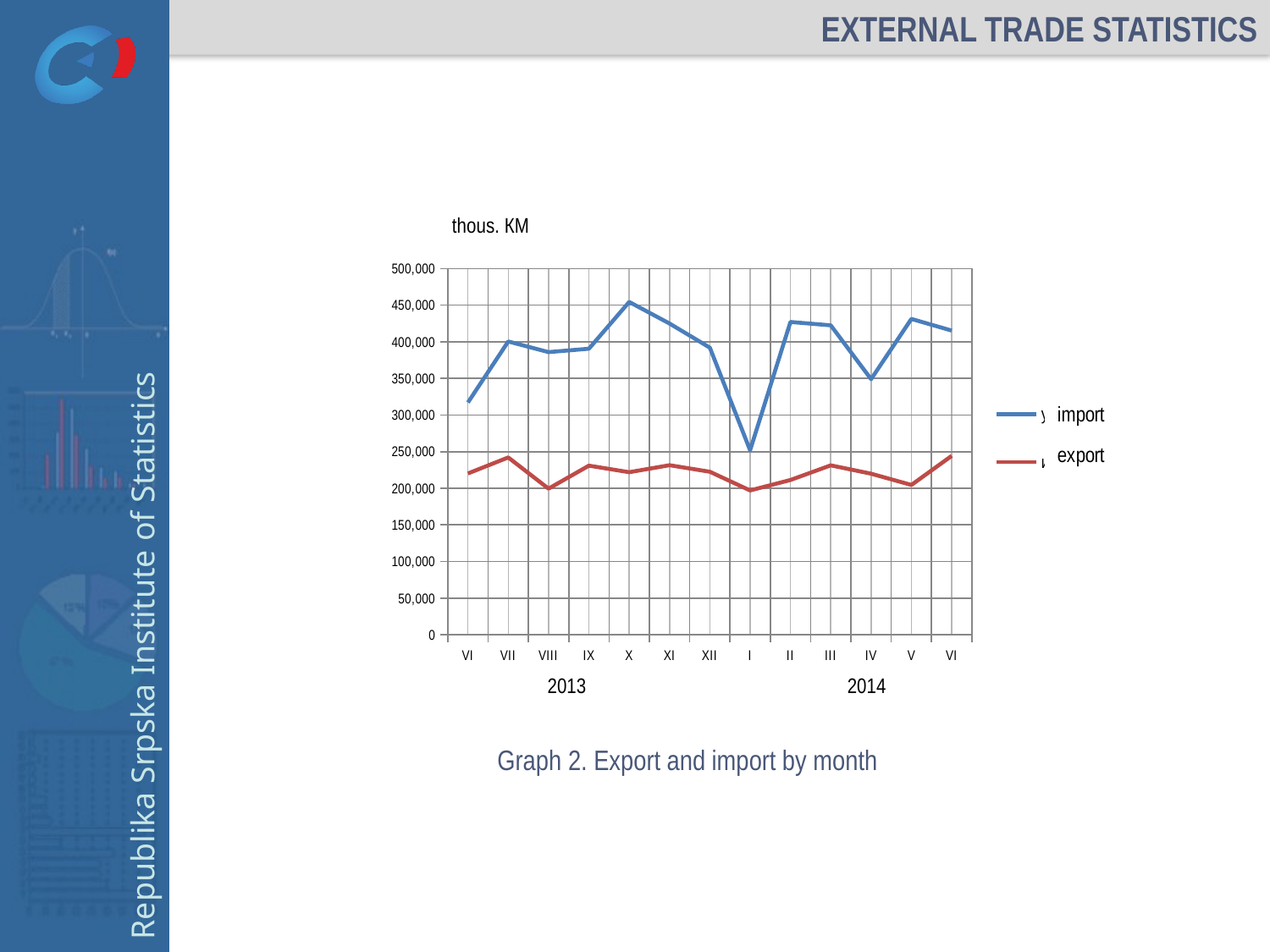
How many monthly points are plotted along the x axis? 13 Is the import value for II 2014 greater or less than 400,000? greater What unit is stated above the chart? thous. KM Which series is drawn in blue? import In which month does the import line reach its highest value? X 2013 Is the export value for X 2013 greater or less than 200,000? greater In which month does the import line reach its lowest value? I 2014 What kind of chart is shown on the slide? line chart How many series does the legend list? 2 Does the import line rise or fall from XII 2013 to I 2014? fall Which is larger in X 2013, import or export? import Is the import value for VI 2013 greater or less than 300,000? greater